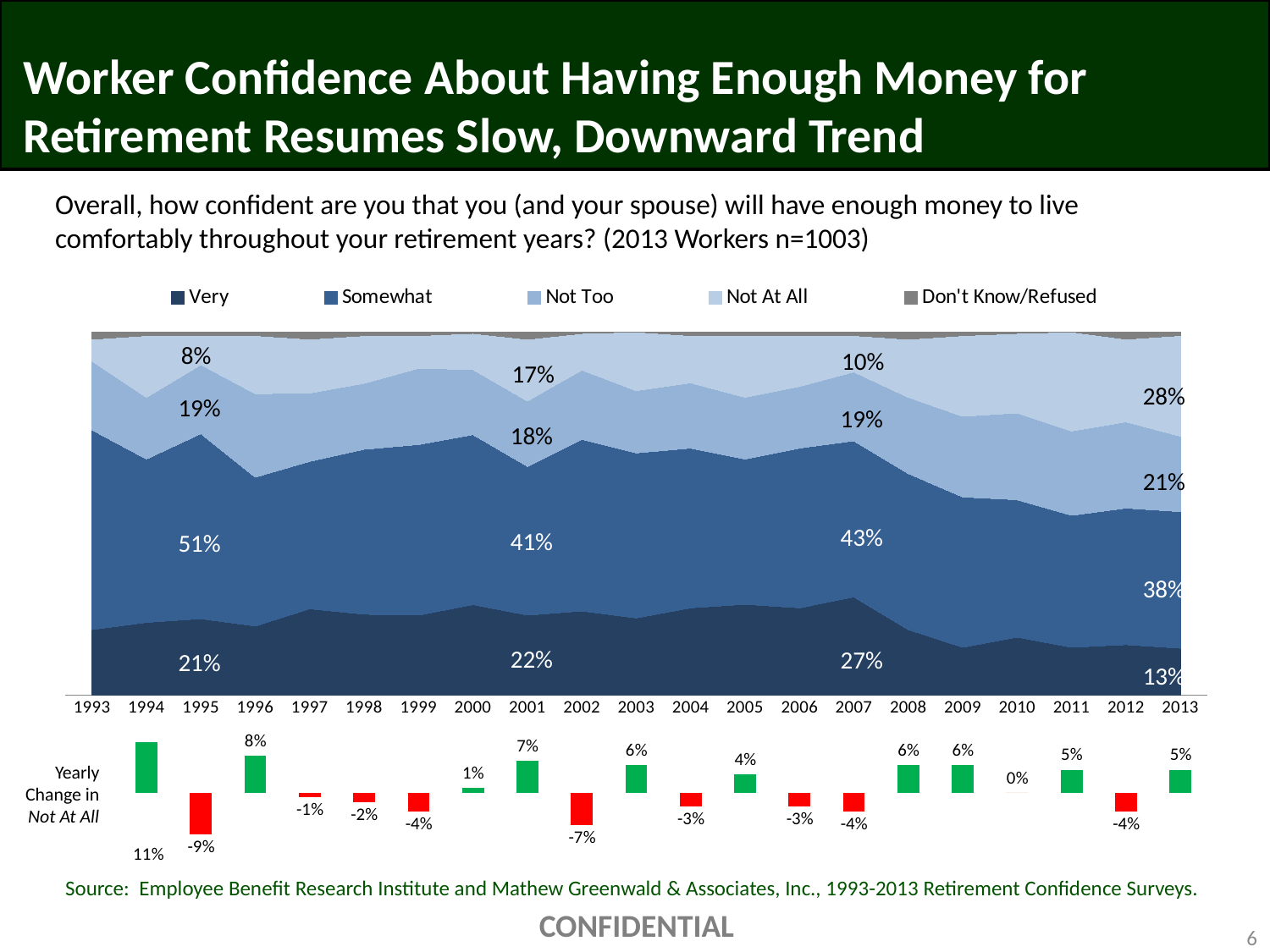
In the 'Yearly Change in Not At All' bar chart, which year has the largest positive change? 1994 In the stacked area chart, what percentage of workers were 'Not At All' confident in 2007? 10% In the 'Yearly Change in Not At All' bar chart, which year has the lowest value? 1995 How many series does the legend of the stacked area chart list? 5 In the stacked area chart, what percentage of workers were 'Very' confident in 2013? 13% In the stacked area chart, what is the difference between the 'Not At All' share in 2013 and in 2007? 18 percentage points In the 'Yearly Change in Not At All' bar chart, what is the value for 2010? 0% What kind of chart is the main chart showing confidence levels from 1993 to 2013? Stacked area chart In the stacked area chart, which is larger: the 'Very' share in 2007 or the 'Very' share in 2013? 2007 In the stacked area chart, what percentage of workers were 'Not Too' confident in 2001? 18% In the stacked area chart, what percentage of workers were 'Somewhat' confident in 1995? 51% How many years are shown on the x axis of the stacked area chart? 21